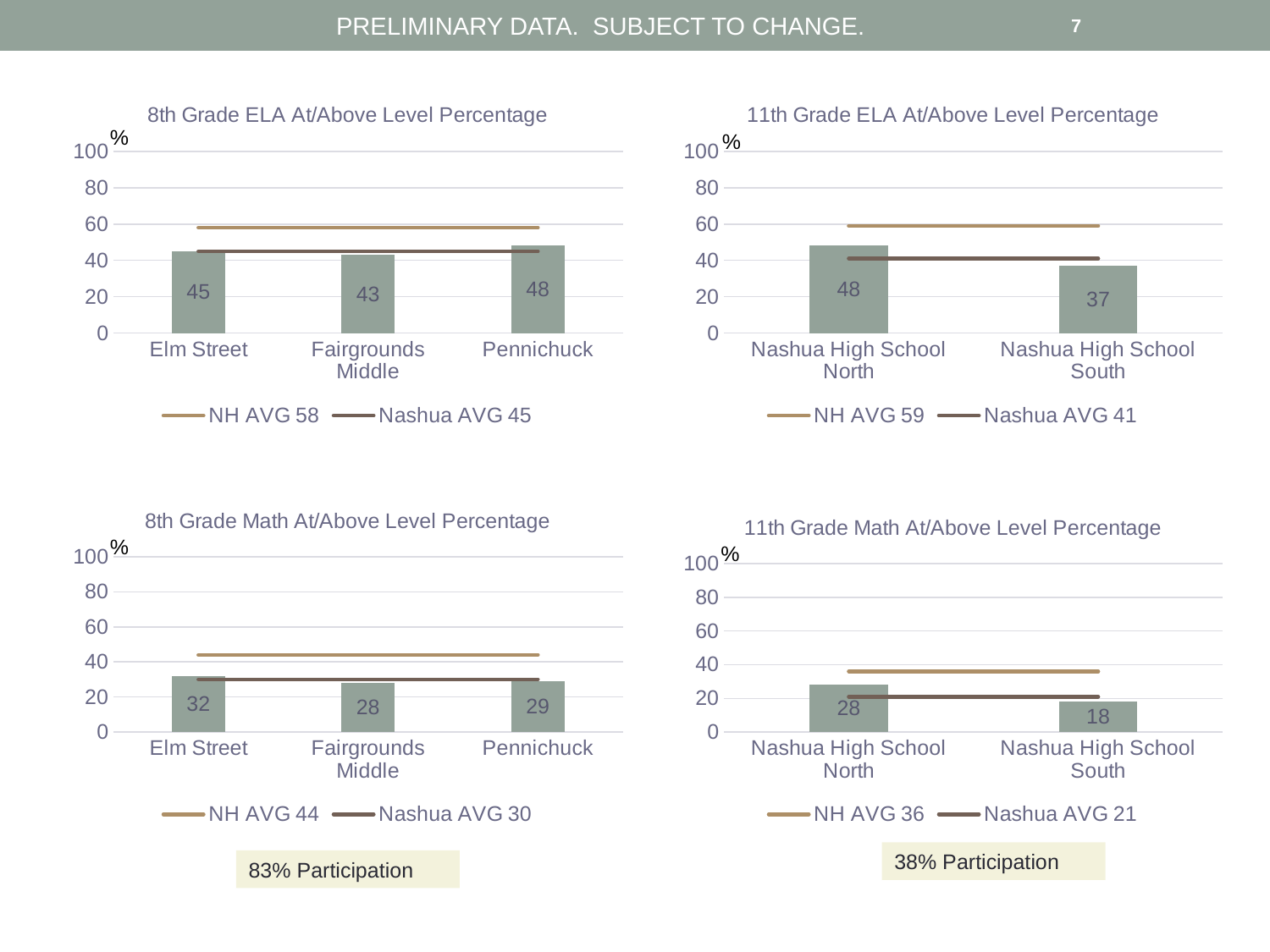
How many schools are shown in the 8th Grade Math At/Above Level Percentage chart? 3 In the 11th Grade Math At/Above Level Percentage chart, what is the value for Nashua High School South? 18 In the 11th Grade ELA At/Above Level Percentage chart, what is the difference between Nashua High School North and Nashua High School South? 11 In the 8th Grade ELA At/Above Level Percentage chart, what is the value for Fairgrounds Middle? 43 In the 8th Grade Math At/Above Level Percentage chart, what is the value for Elm Street? 32 In the 11th Grade Math At/Above Level Percentage chart, which is larger, Nashua High School North or Nashua High School South? Nashua High School North What type of chart is the 11th Grade ELA At/Above Level Percentage chart? Bar chart In the 8th Grade ELA At/Above Level Percentage chart, which school has the highest value? Pennichuck In the 8th Grade ELA At/Above Level Percentage chart, what NH AVG value does the legend show? 58 In the 11th Grade ELA At/Above Level Percentage chart, what is the value for Nashua High School South? 37 In the 8th Grade Math At/Above Level Percentage chart, which school has the lowest value? Fairgrounds Middle What participation percentage is shown below the 11th Grade Math At/Above Level Percentage chart? 38% Participation